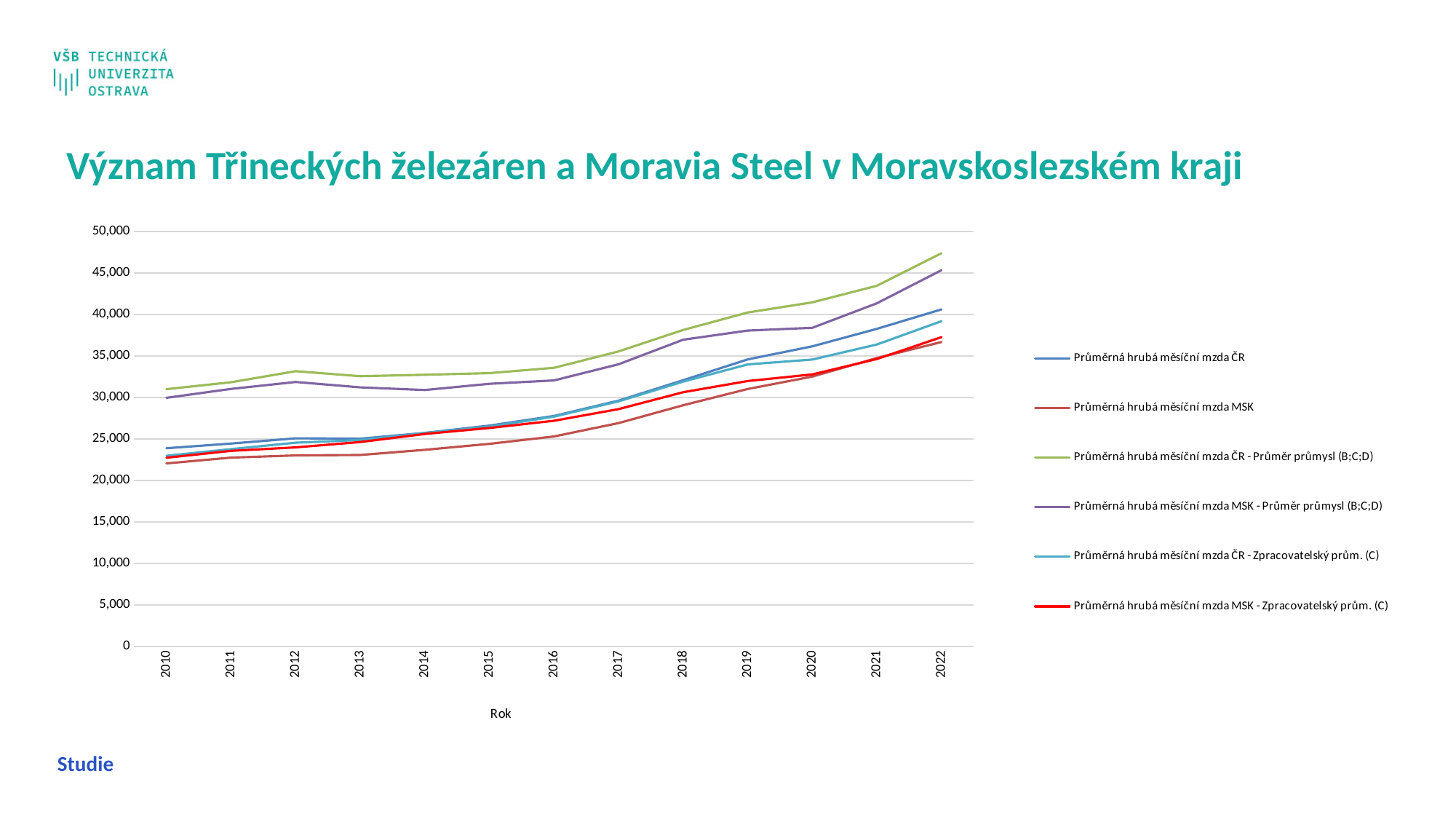
In 2016, which is larger: 'Průměrná hrubá měsíční mzda ČR - Průměr průmysl (B;C;D)' or 'Průměrná hrubá měsíční mzda ČR'? Průměrná hrubá měsíční mzda ČR - Průměr průmysl (B;C;D) Which series has the highest value in 2022? Průměrná hrubá měsíční mzda ČR - Průměr průmysl (B;C;D) What kind of chart is shown on the slide? line chart Which series has the lowest value in 2022? Průměrná hrubá měsíční mzda MSK Do the values of the series 'Průměrná hrubá měsíční mzda ČR' rise or fall from 2010 to 2022? rise Is the 2010 value for 'Průměrná hrubá měsíční mzda MSK' greater or less than 25,000? less How many years are plotted along the x axis? 13 What is the label of the x axis? Rok How many series does the legend list? 6 Is the 2022 value for 'Průměrná hrubá měsíční mzda ČR - Průměr průmysl (B;C;D)' greater or less than 45,000? greater Which series is drawn in red? Průměrná hrubá měsíční mzda MSK - Zpracovatelský prům. (C) Is the 2022 value for 'Průměrná hrubá měsíční mzda MSK - Zpracovatelský prům. (C)' greater or less than 35,000? greater